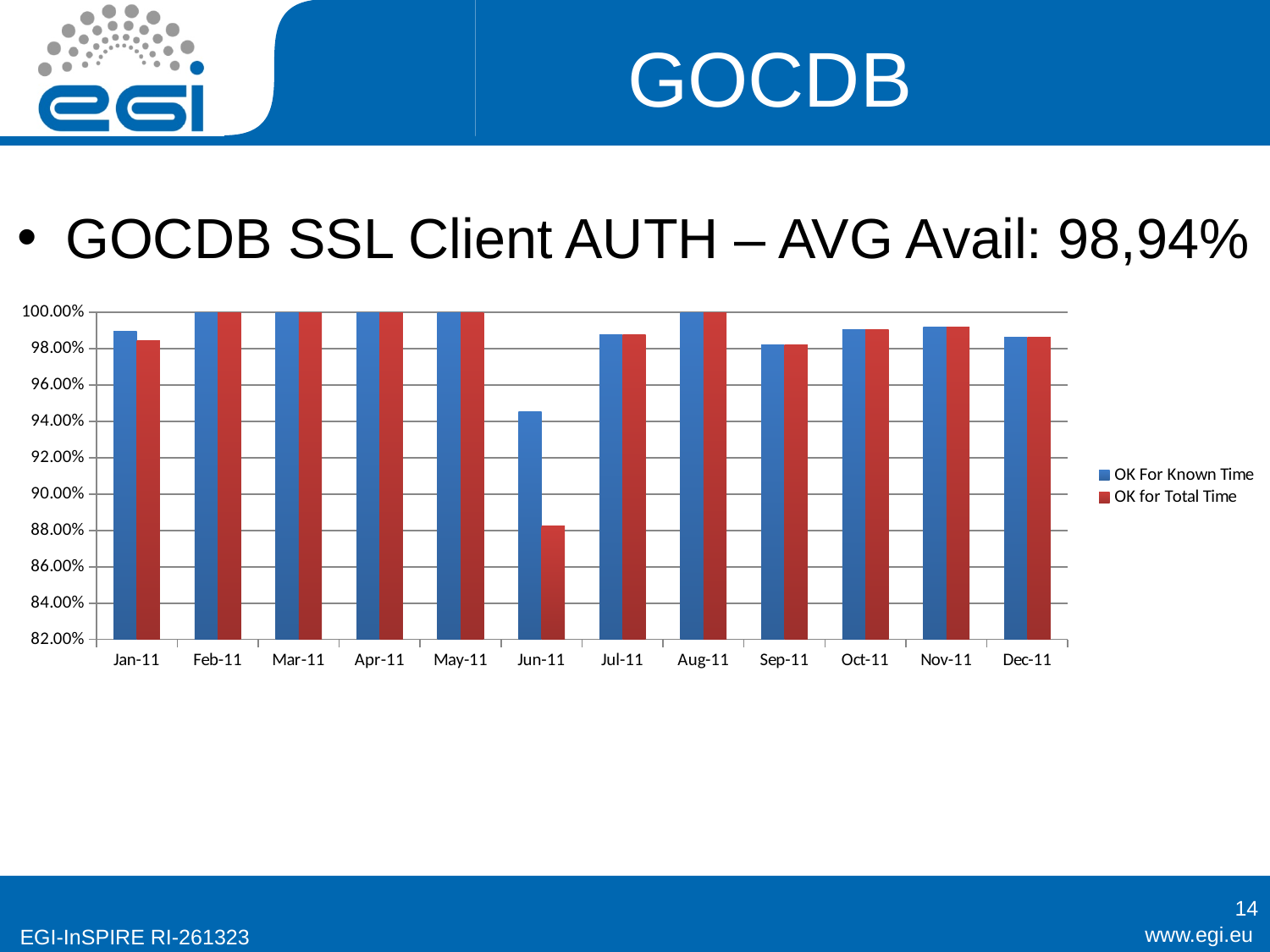
Which month has the lowest value for OK For Known Time? Jun-11 In Jun-11, which is larger: OK For Known Time or OK for Total Time? OK For Known Time Is the value for OK for Total Time in Sep-11 greater or less than 96.00%? greater How many series does the chart legend list? 2 What kind of chart is shown on the slide? bar chart How many months are shown on the x axis of the chart? 12 Which series is shown in red in the chart? OK for Total Time Which month has the lowest value for OK for Total Time? Jun-11 Is the value for OK For Known Time in Jun-11 greater or less than 96.00%? less What is the value for OK For Known Time in Feb-11? 100.00% Is the value for OK for Total Time in Jun-11 greater or less than 90.00%? less